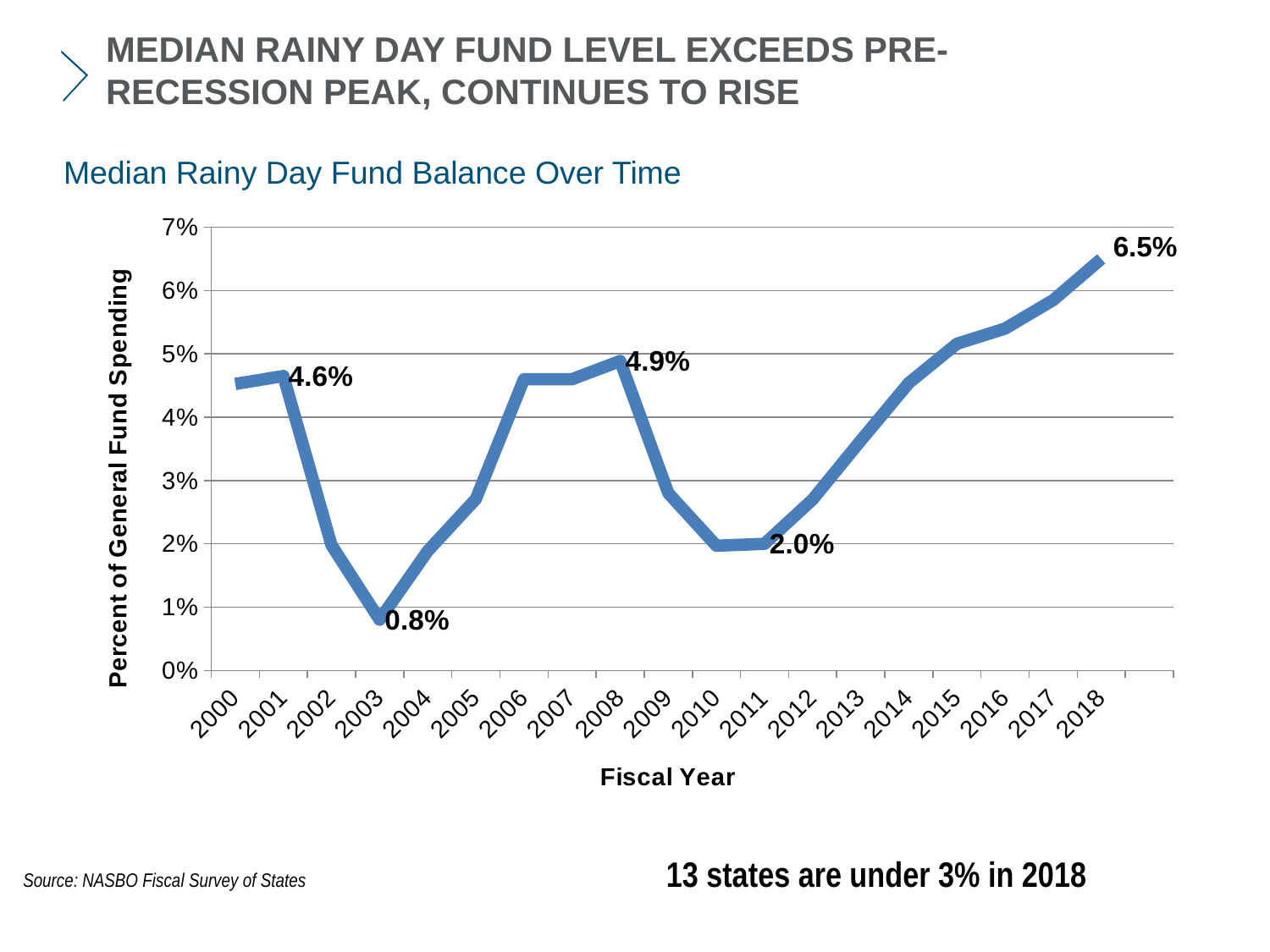
How many fiscal years are shown on the x axis? 19 What is the median rainy day fund balance in fiscal year 2003? 0.8% What value is labeled for fiscal year 2011? 2.0% How much higher is the 2018 value than the 2008 value? 1.6 percentage points What is the median rainy day fund balance in fiscal year 2018? 6.5% Which fiscal year has the highest median rainy day fund balance? 2018 Which fiscal year has the lowest median rainy day fund balance? 2003 What value is labeled for fiscal year 2008? 4.9% Which is larger, the value for 2008 or the value for 2001? 2008 What kind of chart is shown on the slide? Line chart Is the value for fiscal year 2016 greater or less than 5%? greater What is the title of the y axis? Percent of General Fund Spending